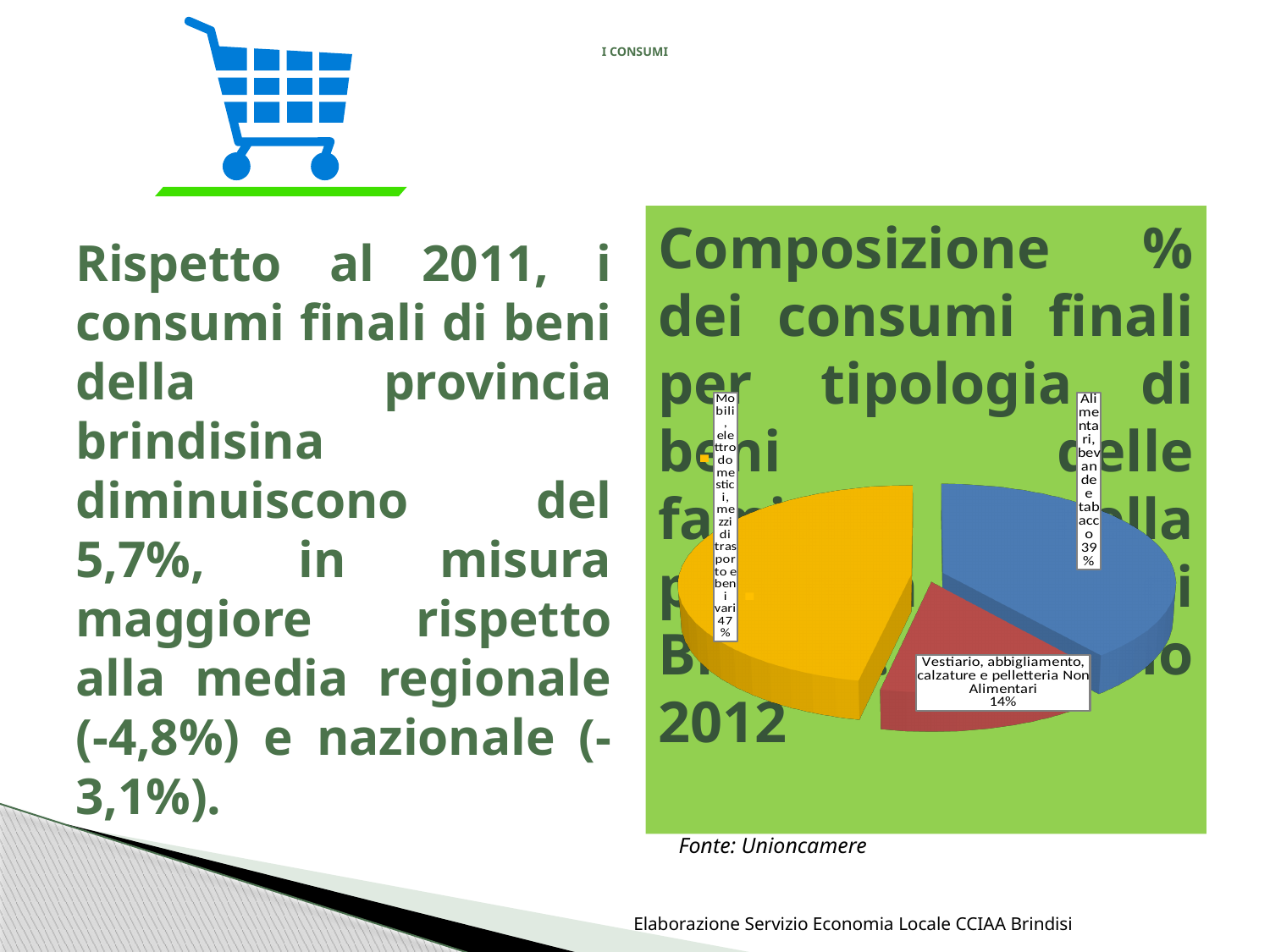
Which is larger: the "Alimentari, bevande e tabacco" slice or the "Vestiario, abbigliamento, calzature e pelletteria Non Alimentari" slice? Alimentari, bevande e tabacco What is the combined share of the "Alimentari, bevande e tabacco" and "Vestiario, abbigliamento, calzature e pelletteria Non Alimentari" slices? 53% What source is cited below the pie chart? Unioncamere What share of the pie is "Alimentari, bevande e tabacco"? 39% What is the difference in percentage points between the "Mobili, elettrodomestici, mezzi di trasporto e beni vari" slice and the "Alimentari, bevande e tabacco" slice? 8 How many slices does the pie chart have? 3 Which category has the smallest slice of the pie? Vestiario, abbigliamento, calzature e pelletteria Non Alimentari Which category has the largest slice of the pie? Mobili, elettrodomestici, mezzi di trasporto e beni vari What colour is the "Alimentari, bevande e tabacco" slice? blue What share of the pie is "Mobili, elettrodomestici, mezzi di trasporto e beni vari"? 47% What share of the pie is "Vestiario, abbigliamento, calzature e pelletteria Non Alimentari"? 14% What kind of chart is shown on the slide? pie chart